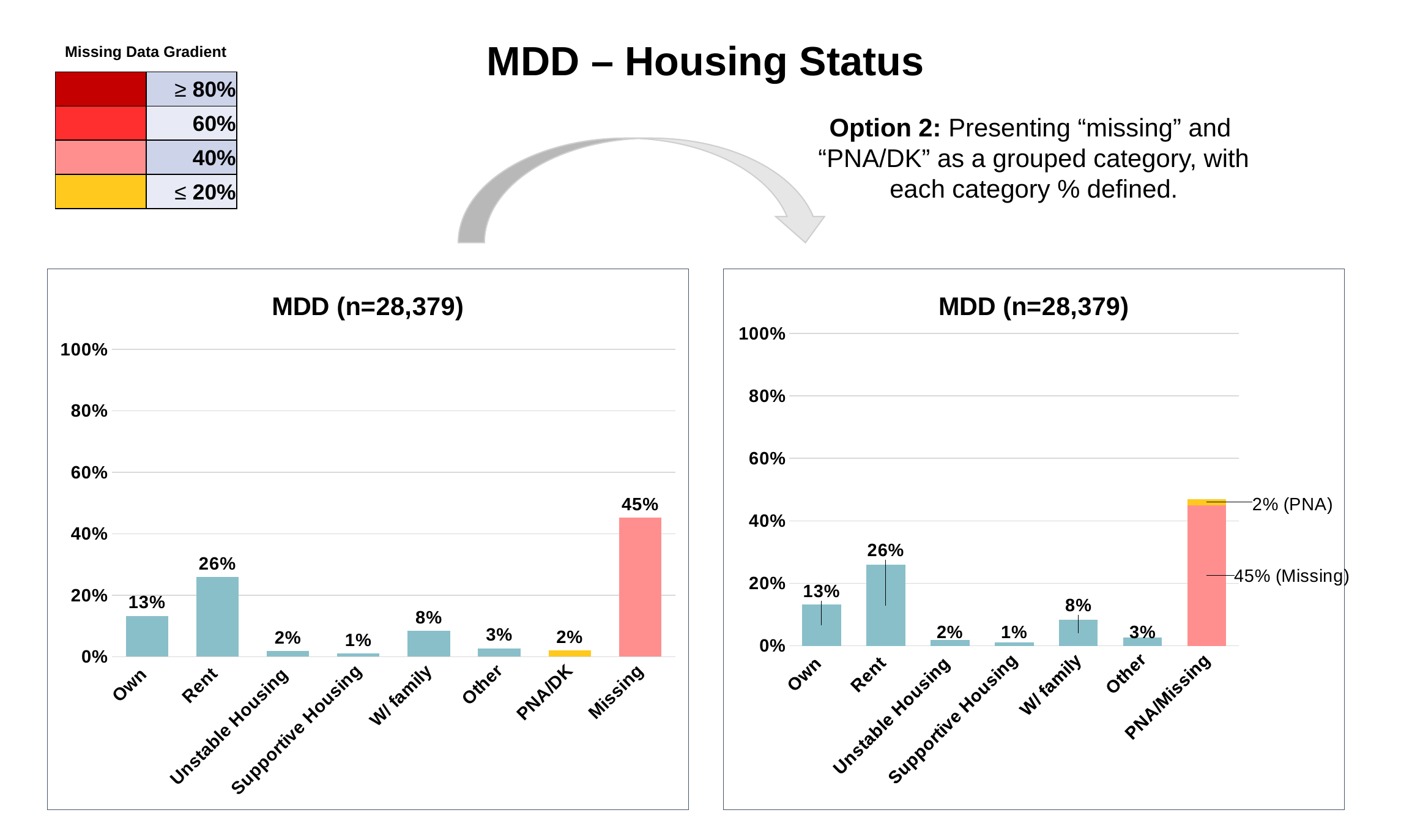
In the left chart, what is the value for Rent? 26% In the left chart, what is the difference between the values for Rent and Own? 13% In the right chart, what is the Missing portion of the PNA/Missing bar? 45% In the left chart, how many categories are shown on the x axis? 8 In the right chart, what is the total of the stacked PNA/Missing bar? 47% In the right chart, how many categories are shown on the x axis? 7 What kind of chart is the left chart? Bar chart In the right chart, which is larger, the value for Own or the value for Other? Own In the left chart, which category has the lowest value? Supportive Housing In the right chart, what is the value for W/ family? 8% In the left chart, what is the value for Missing? 45% In the left chart, which category has the highest value? Missing